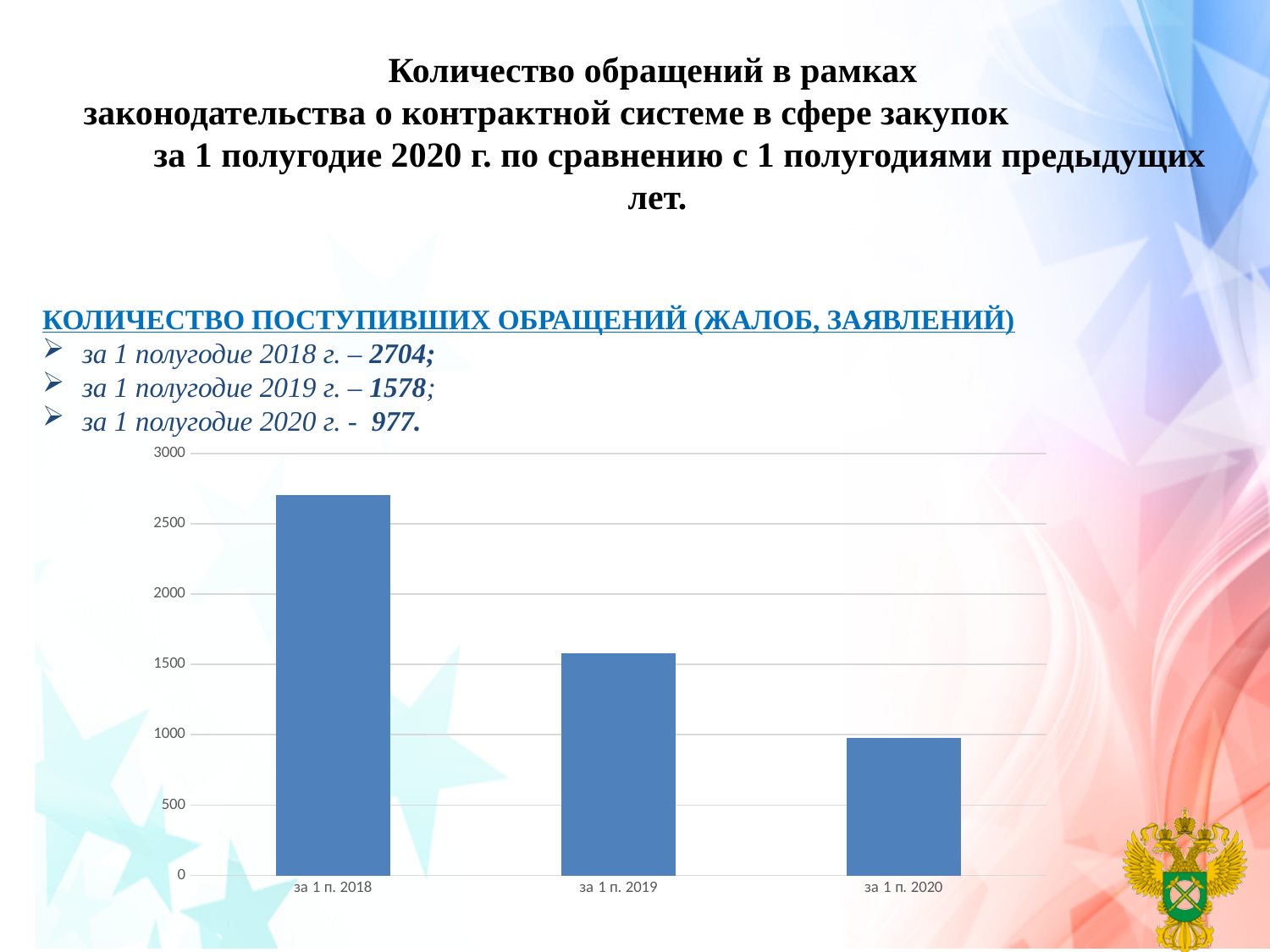
Is the value for за 1 п. 2019 greater or less than 1500? greater How many bars (categories) does the chart show? 3 According to the slide, how many обращений were received за 1 полугодие 2019 г.? 1578 Is the value for за 1 п. 2020 greater or less than 1000? less According to the slide, what is the difference between the number of обращений за 1 полугодие 2018 г. and за 1 полугодие 2020 г.? 1727 Which category has the highest bar? за 1 п. 2018 Which category has the lowest bar? за 1 п. 2020 What is the highest value shown on the vertical axis of the chart? 3000 Is the value for за 1 п. 2018 greater or less than 2500? greater What kind of chart is shown on the slide? bar chart Which is larger, the value for за 1 п. 2019 or за 1 п. 2020? за 1 п. 2019 Do the values rise or fall from за 1 п. 2018 to за 1 п. 2020? fall